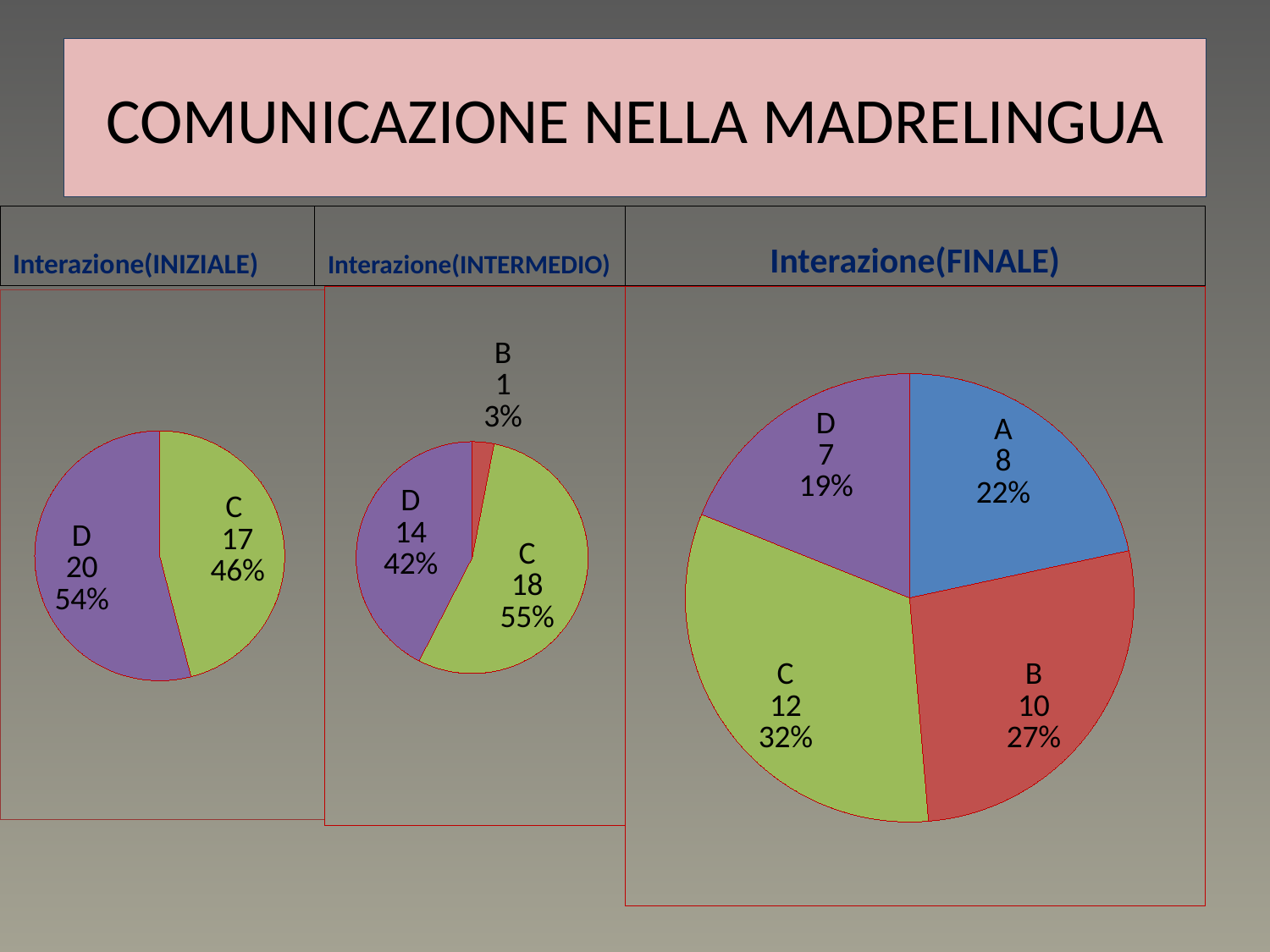
In the Interazione(FINALE) chart, what colour is the slice for category A? Blue In the Interazione(INTERMEDIO) chart, which category has the largest slice? C What type of chart is the Interazione(INIZIALE) chart? Pie chart In the Interazione(FINALE) chart, which is larger, the value for B or the value for D? B In the Interazione(INIZIALE) chart, what value is shown for category D? 20 In the Interazione(FINALE) chart, what value is shown for category A? 8 In the Interazione(FINALE) chart, how many categories are shown? 4 In the Interazione(INIZIALE) chart, what share of the pie does category C have? 46% In the Interazione(FINALE) chart, which category has the smallest slice? D In the Interazione(FINALE) chart, what is the difference between the values for C and B? 2 In the Interazione(INTERMEDIO) chart, what share of the pie does category D have? 42% In the Interazione(INTERMEDIO) chart, what value is shown for category B? 1